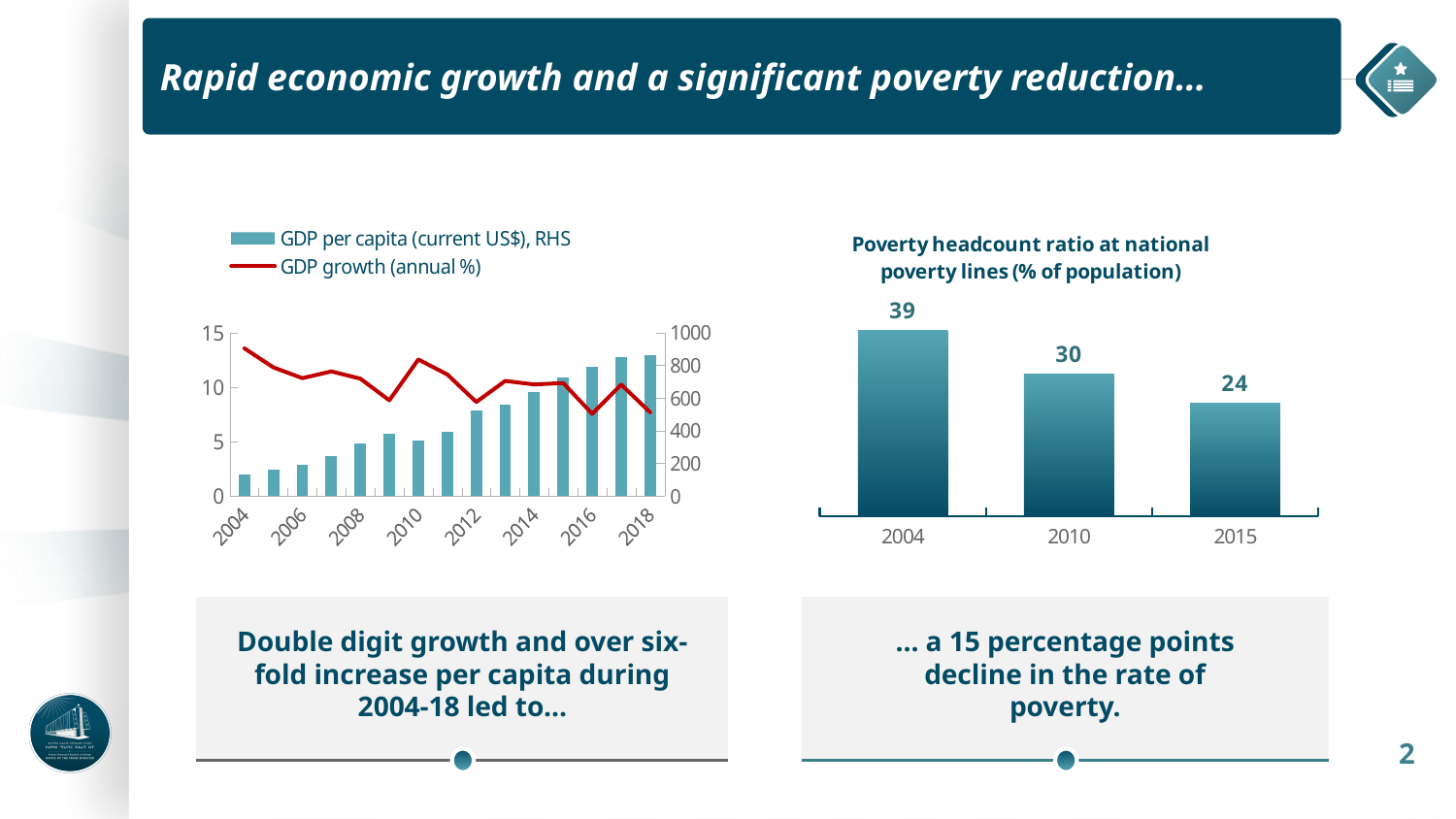
In the chart titled 'Poverty headcount ratio at national poverty lines (% of population)', how many years are shown? 3 In the chart titled 'Poverty headcount ratio at national poverty lines (% of population)', which year has the highest value? 2004 In the chart titled 'Poverty headcount ratio at national poverty lines (% of population)', which year has the lowest value? 2015 In the chart titled 'Poverty headcount ratio at national poverty lines (% of population)', what is the difference between the 2004 and 2015 values? 15 In the chart on the left of the slide, do the GDP per capita (current US$) bars rise or fall from 2004 to 2018? rise In the chart on the left of the slide, is the GDP growth (annual %) value for 2004 greater or less than 10? greater In the chart titled 'Poverty headcount ratio at national poverty lines (% of population)', what is the value for 2015? 24 In the chart on the left of the slide, is the GDP per capita (current US$) value for 2004 greater or less than 200? less In the chart on the left of the slide, is the GDP per capita (current US$) value for 2018 greater or less than 800? greater In the chart titled 'Poverty headcount ratio at national poverty lines (% of population)', do the values rise or fall from 2004 to 2015? fall In the chart on the left of the slide, how many series does the legend list? 2 In the chart titled 'Poverty headcount ratio at national poverty lines (% of population)', what is the value for 2004? 39